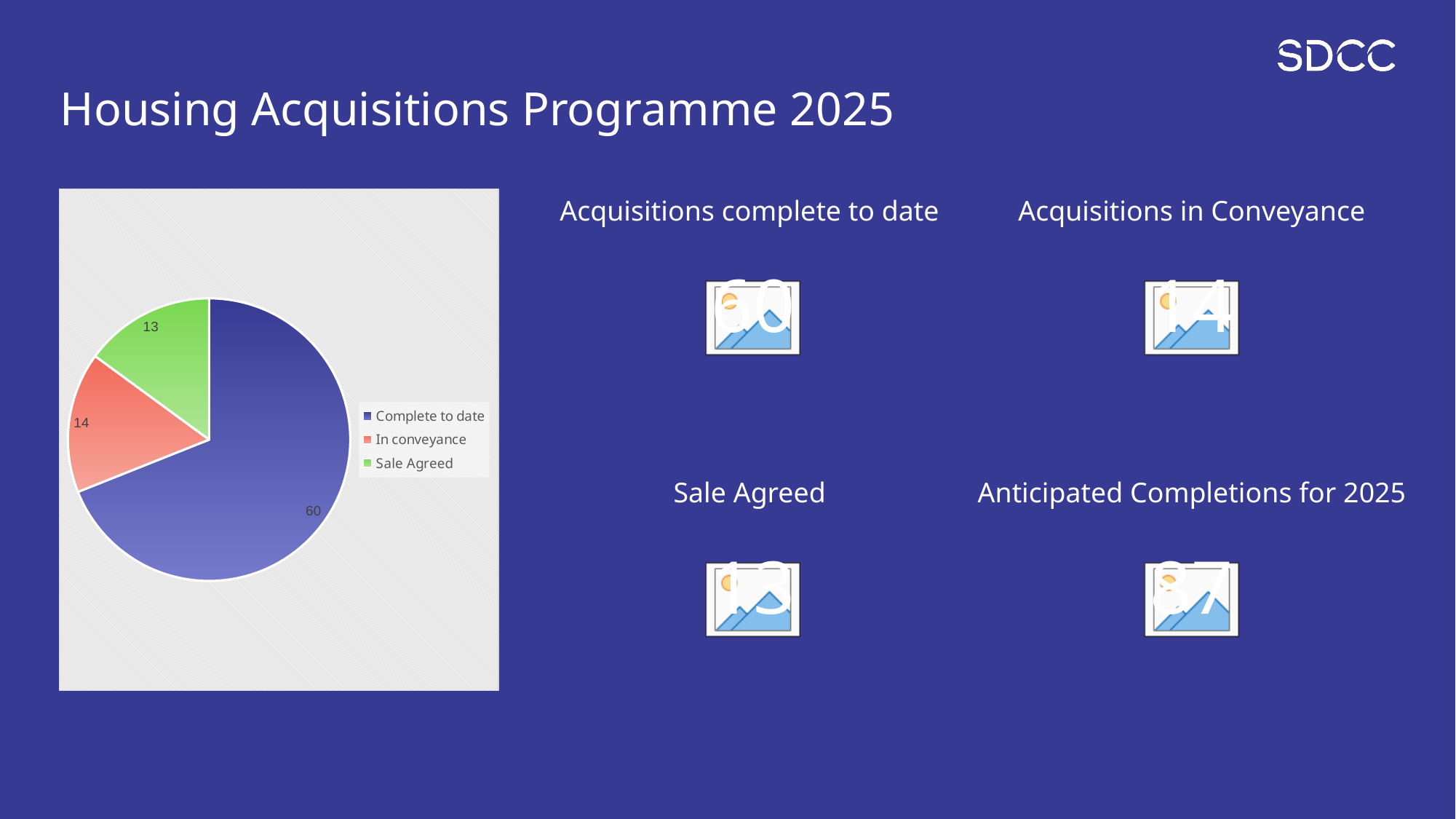
What kind of chart is shown on the slide? pie chart Which category has the largest slice in the pie chart? Complete to date What is the total of all the slices in the pie chart? 87 What is the value for In conveyance in the pie chart? 14 What is the value for Sale Agreed in the pie chart? 13 What is the difference between the Complete to date value and the In conveyance value? 46 What colour is the Sale Agreed slice in the pie chart? green How many slices does the pie chart have? 3 Which category has the smallest slice in the pie chart? Sale Agreed What is the difference between the In conveyance value and the Sale Agreed value? 1 What is the value for Complete to date in the pie chart? 60 Which is larger, In conveyance or Sale Agreed? In conveyance